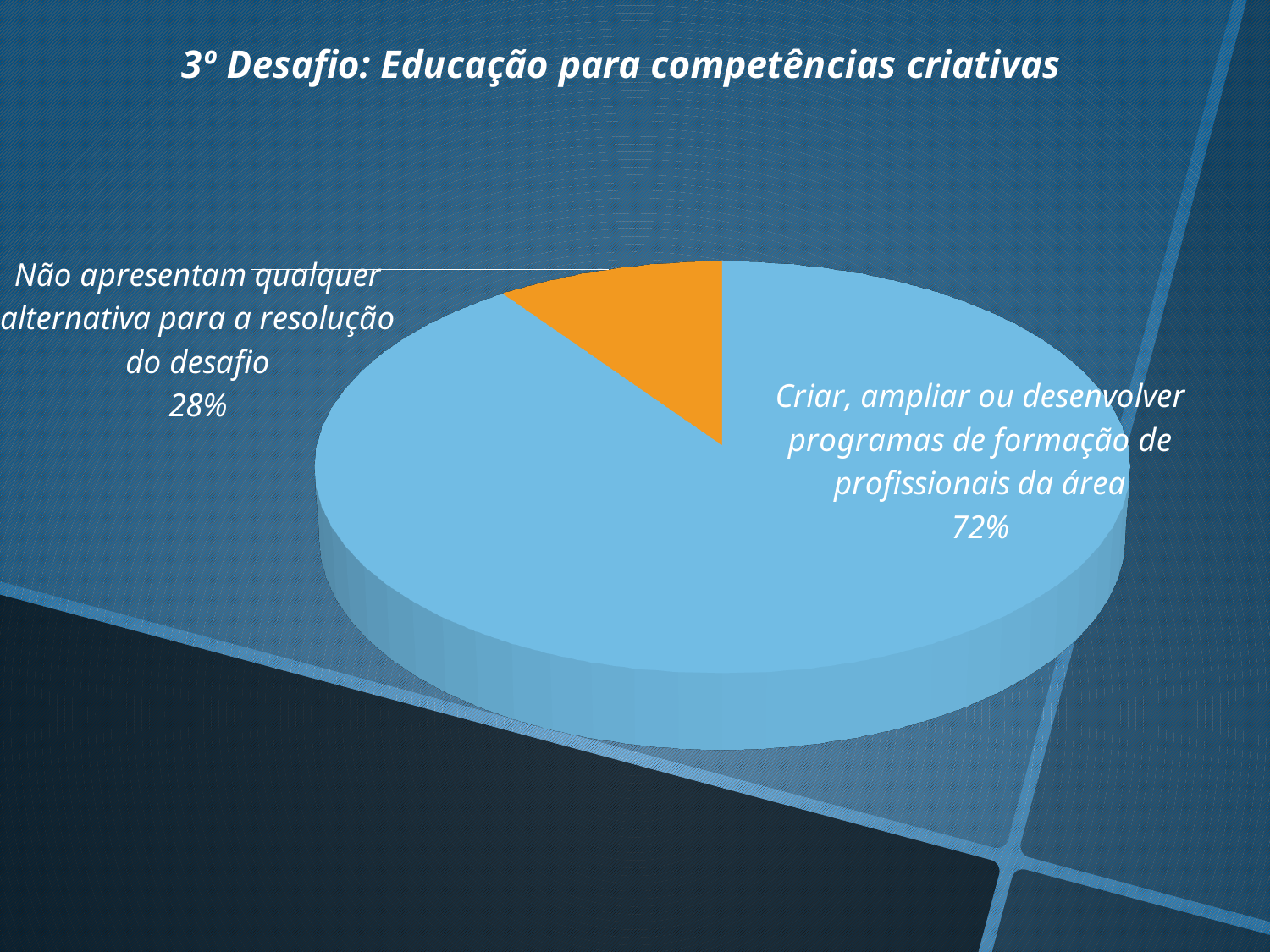
How many slices does the pie chart have? 2 What percentage is shown for "Criar, ampliar ou desenvolver programas de formação de profissionais da área"? 72% Which slice of the pie is the smallest? Não apresentam qualquer alternativa para a resolução do desafio What colour is the slice for "Não apresentam qualquer alternativa para a resolução do desafio"? orange What percentage is shown for "Não apresentam qualquer alternativa para a resolução do desafio"? 28% What is the difference in percentage points between the two slices of the pie? 44 Which slice of the pie is the largest? Criar, ampliar ou desenvolver programas de formação de profissionais da área What share of the pie does the "Não apresentam qualquer alternativa para a resolução do desafio" slice represent? 28% Which is larger: the share for "Criar, ampliar ou desenvolver programas de formação de profissionais da área" or the share for "Não apresentam qualquer alternativa para a resolução do desafio"? Criar, ampliar ou desenvolver programas de formação de profissionais da área What kind of chart is shown on the slide? pie chart What is the title of the slide containing the pie chart? 3º Desafio: Educação para competências criativas